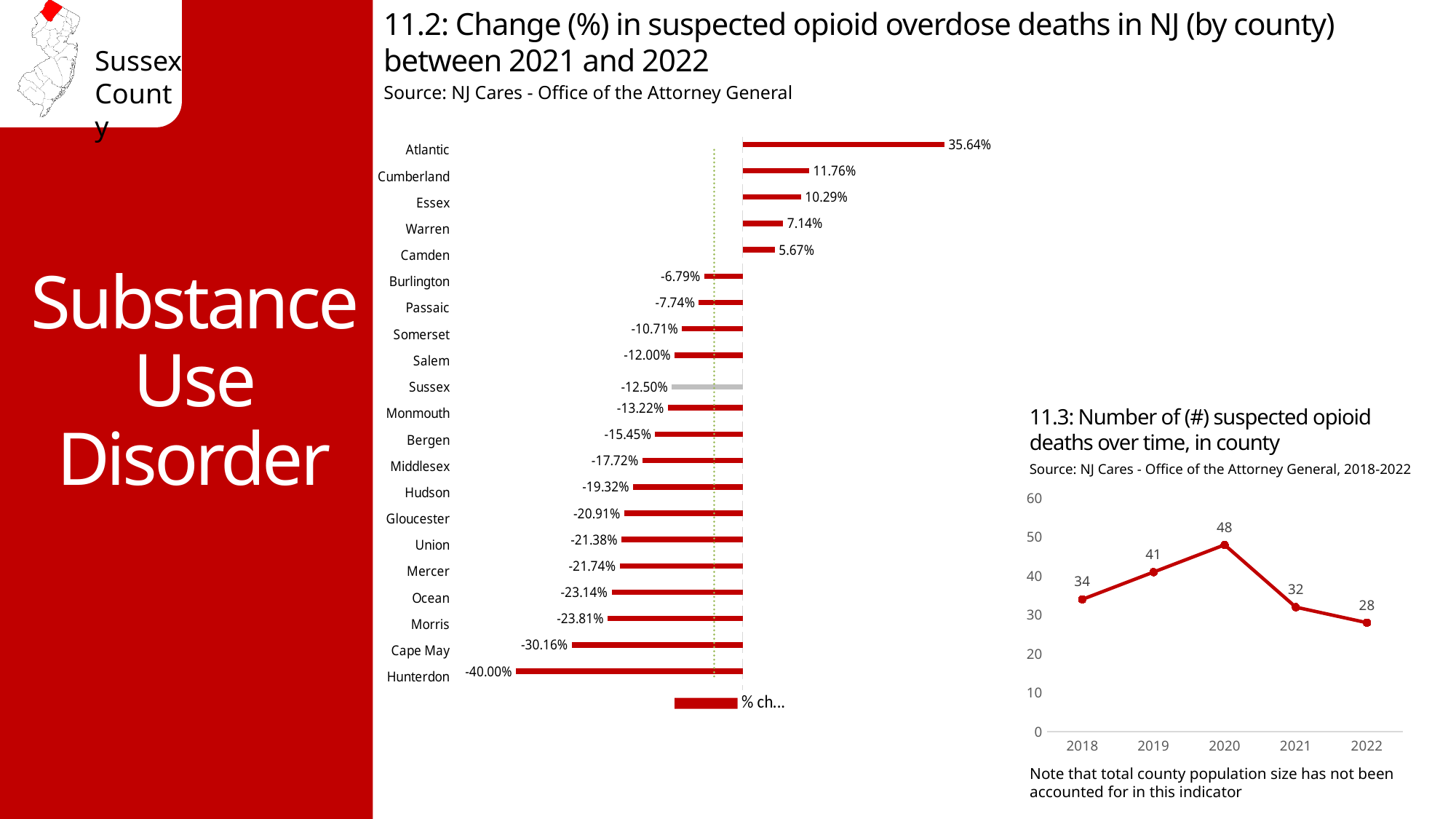
What kind of chart is '11.2: Change (%) in suspected opioid overdose deaths in NJ (by county) between 2021 and 2022'? Bar chart In the chart '11.2: Change (%) in suspected opioid overdose deaths in NJ (by county) between 2021 and 2022', what is the value for Cape May? -30.16% In the chart '11.2: Change (%) in suspected opioid overdose deaths in NJ (by county) between 2021 and 2022', which county has the lowest value? Hunterdon What kind of chart is '11.3: Number of (#) suspected opioid deaths over time, in county'? Line chart In the chart '11.2: Change (%) in suspected opioid overdose deaths in NJ (by county) between 2021 and 2022', what is the value for Sussex? -12.50% In the chart '11.3: Number of (#) suspected opioid deaths over time, in county', which year has the lowest value? 2022 In the chart '11.2: Change (%) in suspected opioid overdose deaths in NJ (by county) between 2021 and 2022', how many counties are shown? 21 In the chart '11.3: Number of (#) suspected opioid deaths over time, in county', what is the difference between the values for 2020 and 2022? 20 In the chart '11.3: Number of (#) suspected opioid deaths over time, in county', how many years are plotted? 5 In the chart '11.2: Change (%) in suspected opioid overdose deaths in NJ (by county) between 2021 and 2022', which county has the highest value? Atlantic In the chart '11.2: Change (%) in suspected opioid overdose deaths in NJ (by county) between 2021 and 2022', which is larger, the value for Cumberland or the value for Essex? Cumberland In the chart '11.3: Number of (#) suspected opioid deaths over time, in county', what is the value for 2020? 48